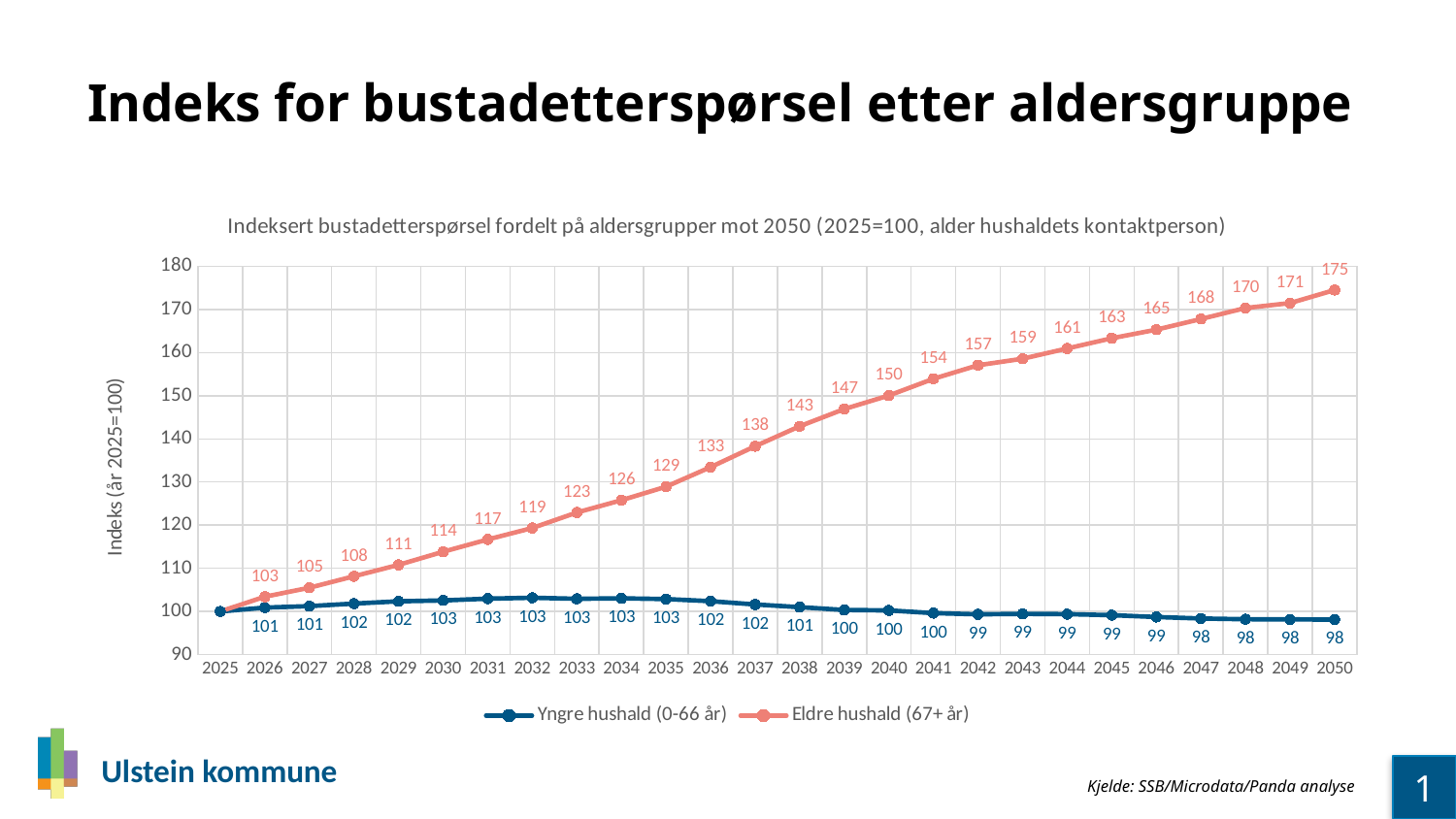
What kind of chart is shown on the slide? Line chart What is the difference between Eldre hushald (67+ år) and Yngre hushald (0-66 år) in 2050? 77 Does the Eldre hushald (67+ år) series rise or fall from 2025 to 2050? Rise In which year does Eldre hushald (67+ år) reach its highest value? 2050 What is the value for Yngre hushald (0-66 år) in 2050? 98 What is the value for Yngre hushald (0-66 år) in 2032? 103 Which series has the larger value in 2045, Eldre hushald (67+ år) or Yngre hushald (0-66 år)? Eldre hushald (67+ år) How many years are plotted along the x axis? 26 What is the value for Eldre hushald (67+ år) in 2040? 150 How many series does the legend list? 2 Is the value for Eldre hushald (67+ år) in 2036 greater or less than 130? greater What is the value for Eldre hushald (67+ år) in 2050? 175